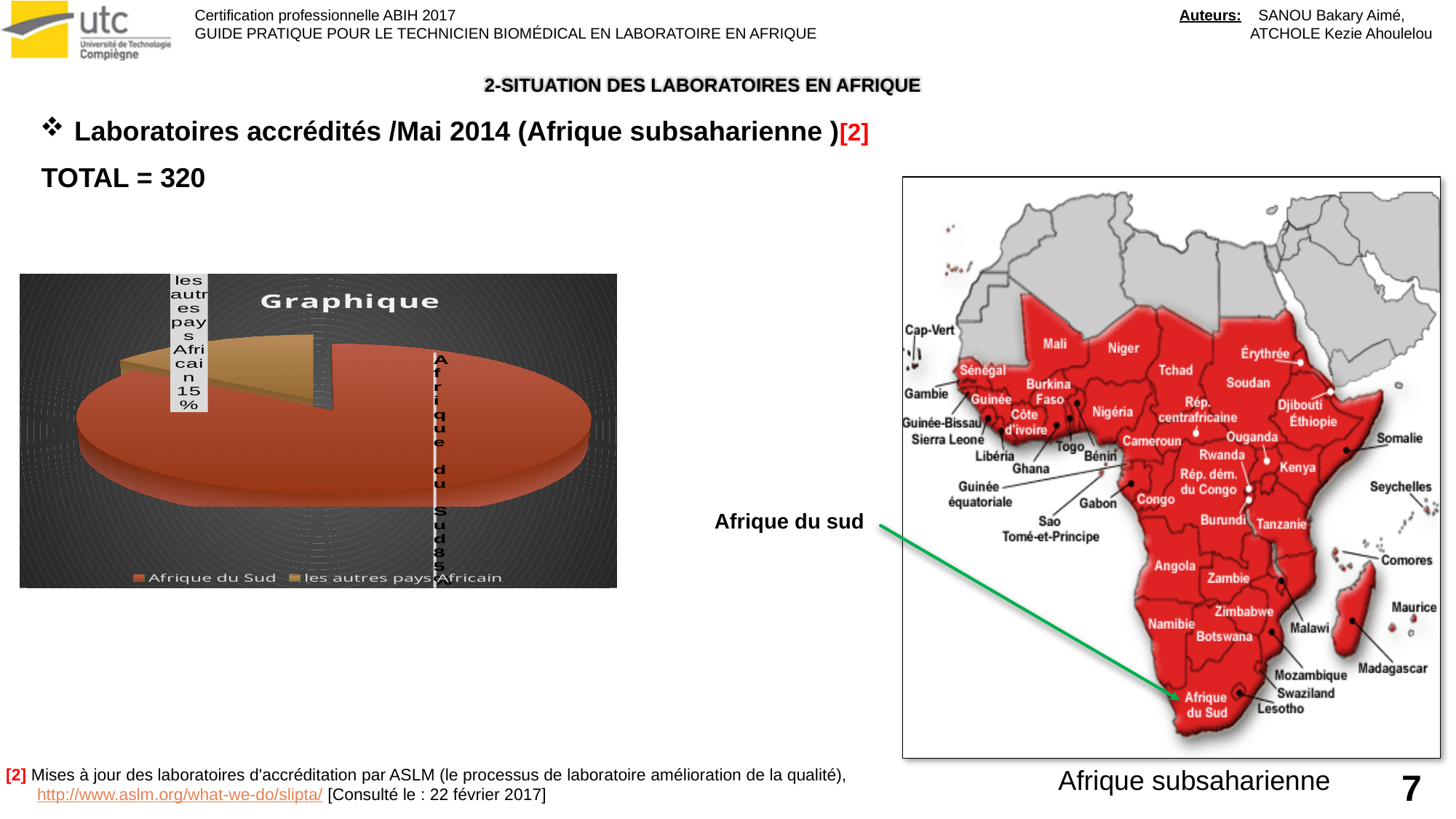
Which slice of the pie is the smallest? les autres pays Africain Which slice of the pie is the largest? Afrique du Sud What share of the pie does 'Afrique du Sud' represent? 85% How many slices does the pie chart have? 2 How many entries does the chart legend list? 2 Which is larger, the share for Afrique du Sud or the share for les autres pays Africain? Afrique du Sud What is the difference in percentage points between the Afrique du Sud share and the les autres pays Africain share? 70 What are the two categories listed in the chart legend? Afrique du Sud and les autres pays Africain What is the title of the chart? Graphique What kind of chart is shown on the slide? pie chart What share of the pie does 'les autres pays Africain' represent? 15%